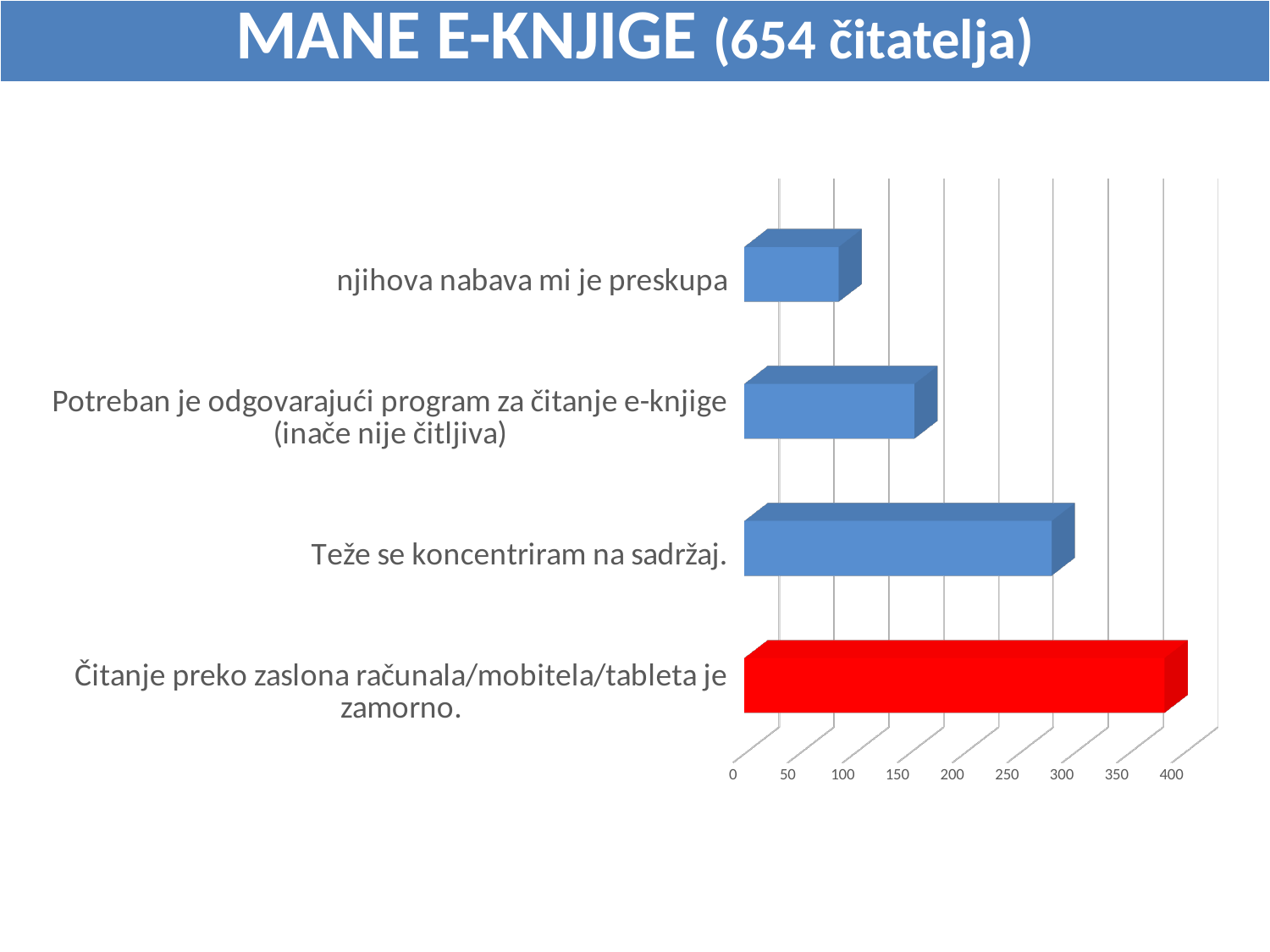
Is the value for "Teže se koncentriram na sadržaj." greater or less than 200? greater What is the title of the slide containing the chart? MANE E-KNJIGE (654 čitatelja) Is the value for "Čitanje preko zaslona računala/mobitela/tableta je zamorno." greater or less than 300? greater What kind of chart is shown on the slide? bar chart How many categories are plotted in the chart? 4 Is the value for "Potreban je odgovarajući program za čitanje e-knjige (inače nije čitljiva)" greater or less than 100? greater Which category has the lowest value? njihova nabava mi je preskupa What colour is the bar for "Čitanje preko zaslona računala/mobitela/tableta je zamorno."? red Which category has the highest value? Čitanje preko zaslona računala/mobitela/tableta je zamorno. Which is larger: the value for "Teže se koncentriram na sadržaj." or the value for "Potreban je odgovarajući program za čitanje e-knjige (inače nije čitljiva)"? Teže se koncentriram na sadržaj.